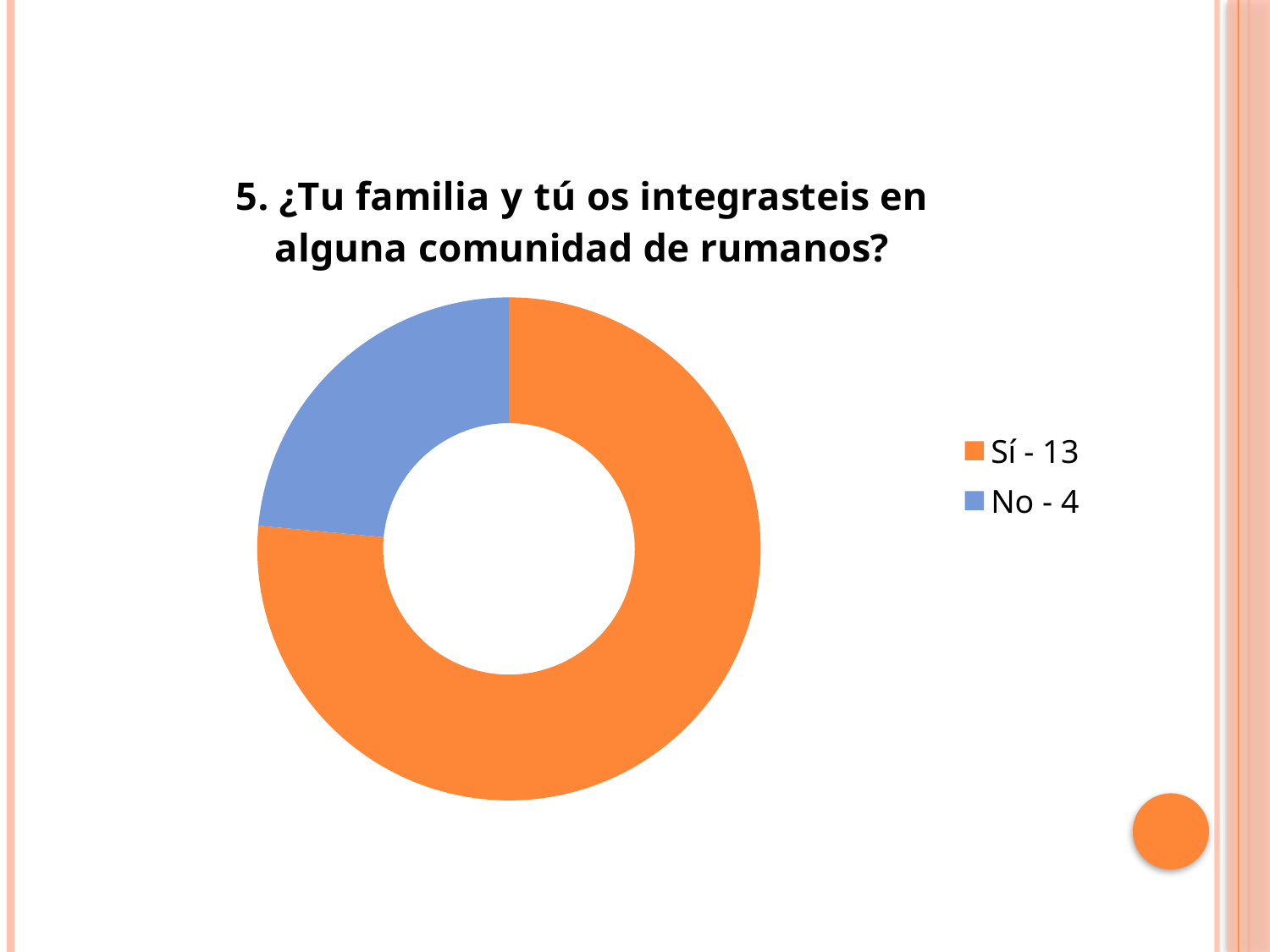
What is the difference between the number of "Sí" and "No" answers? 9 How many respondents answered "Sí"? 13 How many entries does the legend list? 2 What kind of chart is shown on the slide? Doughnut chart What is the total number of responses shown in the chart? 17 How many categories does the chart show? 2 Which answer has the larger share of the chart? Sí What is the title of the chart? 5. ¿Tu familia y tú os integrasteis en alguna comunidad de rumanos? What colour represents the "No" answer in the chart? Blue Is the value for "Sí" larger or smaller than the value for "No"? Larger How many respondents answered "No"? 4 Which answer has the smaller share of the chart? No